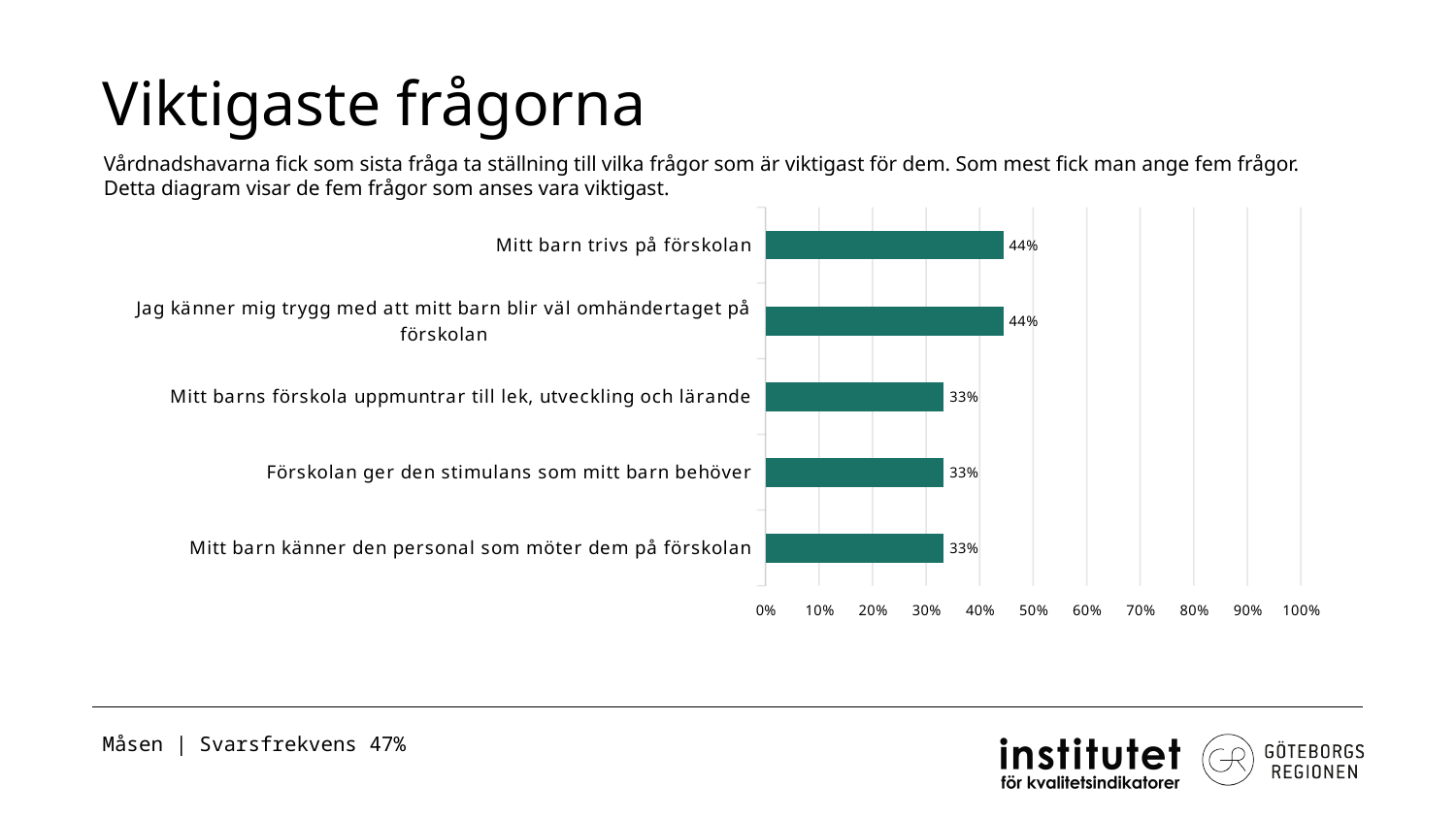
What is the difference between the value for "Mitt barn trivs på förskolan" and the value for "Mitt barn känner den personal som möter dem på förskolan"? 11% What is the value for "Mitt barns förskola uppmuntrar till lek, utveckling och lärande"? 33% How many categories are shown in the chart? 5 What is the title of the slide? Viktigaste frågorna Is the value for "Jag känner mig trygg med att mitt barn blir väl omhändertaget på förskolan" greater or less than 40%? greater What is the value for "Förskolan ger den stimulans som mitt barn behöver"? 33% What is the highest value shown on the x axis? 100% What is the value for "Mitt barn trivs på förskolan"? 44% What is the value for "Jag känner mig trygg med att mitt barn blir väl omhändertaget på förskolan"? 44% Is the value for "Mitt barn känner den personal som möter dem på förskolan" greater or less than 50%? less What kind of chart is shown on the slide? Bar chart Which is larger: the value for "Mitt barn trivs på förskolan" or the value for "Förskolan ger den stimulans som mitt barn behöver"? Mitt barn trivs på förskolan